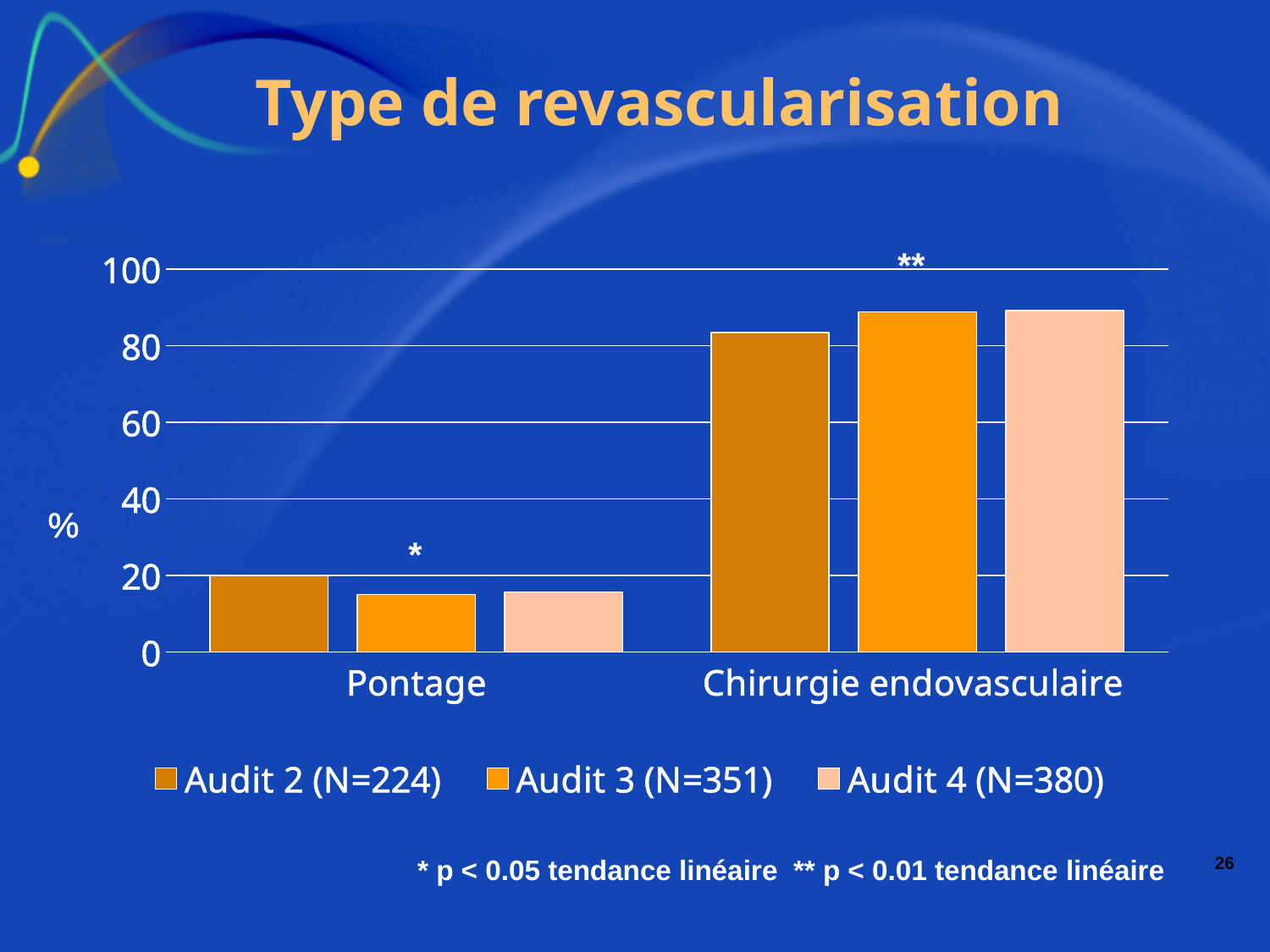
In the Pontage category, which audit has the highest value? Audit 2 (N=224) What sample size (N) is given in the legend for Audit 4? 380 In the Pontage category, which is larger: the value for Audit 2 or the value for Audit 3? Audit 2 (N=224) Is the value for Audit 4 in the Pontage category greater or less than 20? less What is the title of the chart? Type de revascularisation Is the value for Audit 2 in the Chirurgie endovasculaire category greater or less than 80? greater Is the value for Audit 3 in the Pontage category greater or less than 20? less How many series does the legend list? 3 How many categories are shown on the x axis of the chart? 2 Which category, Pontage or Chirurgie endovasculaire, has the higher values? Chirurgie endovasculaire What kind of chart is shown on the slide? bar chart